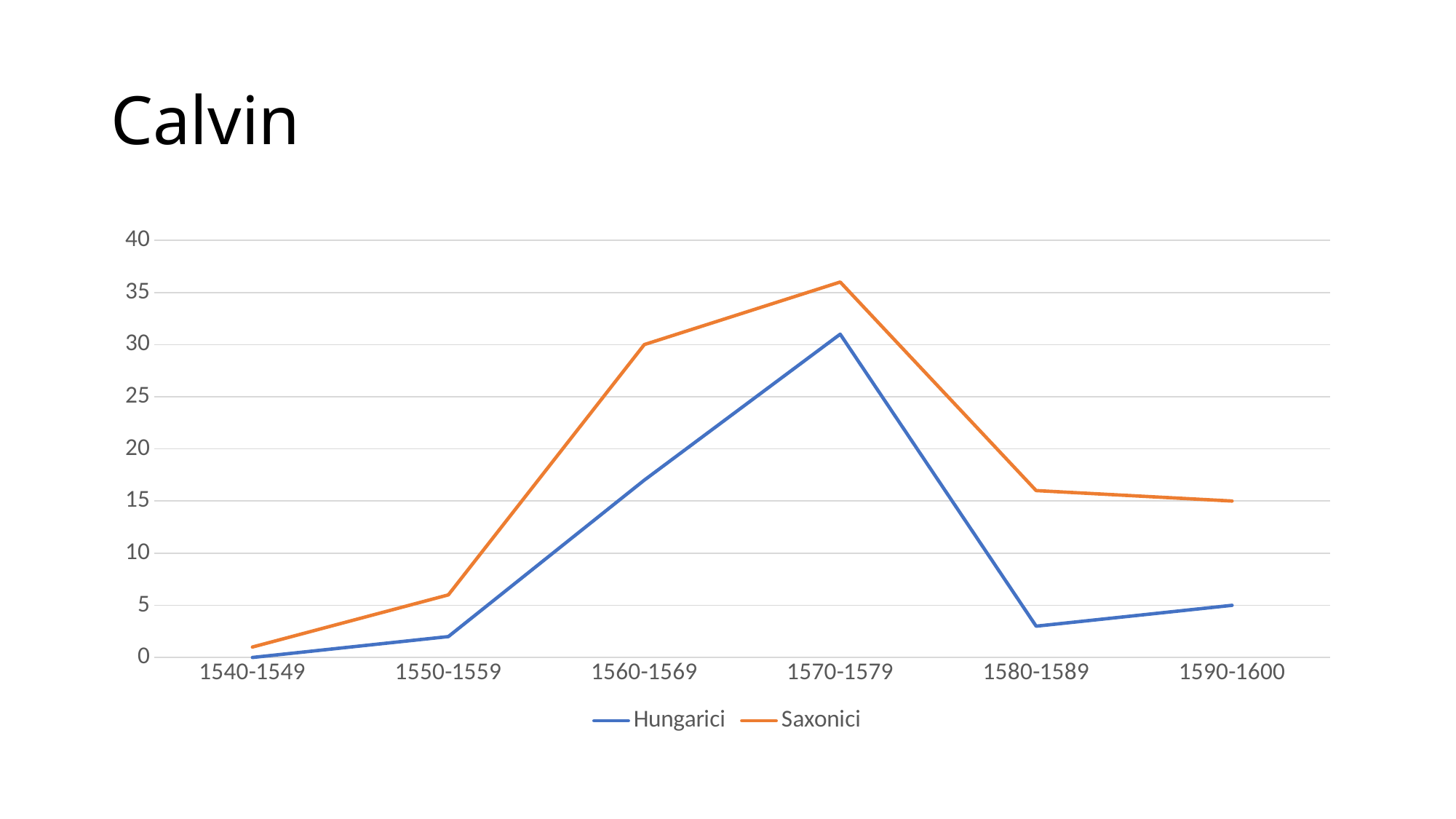
In which period does the Hungarici series reach its highest value? 1570-1579 How many periods are shown on the x axis? 6 How many series does the legend list? 2 Is the Hungarici value for 1560-1569 greater or less than 20? less What kind of chart is shown on the slide? line chart Which series has the larger value in 1580-1589, Hungarici or Saxonici? Saxonici In which period is the Hungarici series at its lowest value? 1540-1549 Is the Hungarici value for 1580-1589 greater or less than 5? less Which series is drawn in orange? Saxonici What is the title of the slide containing the chart? Calvin